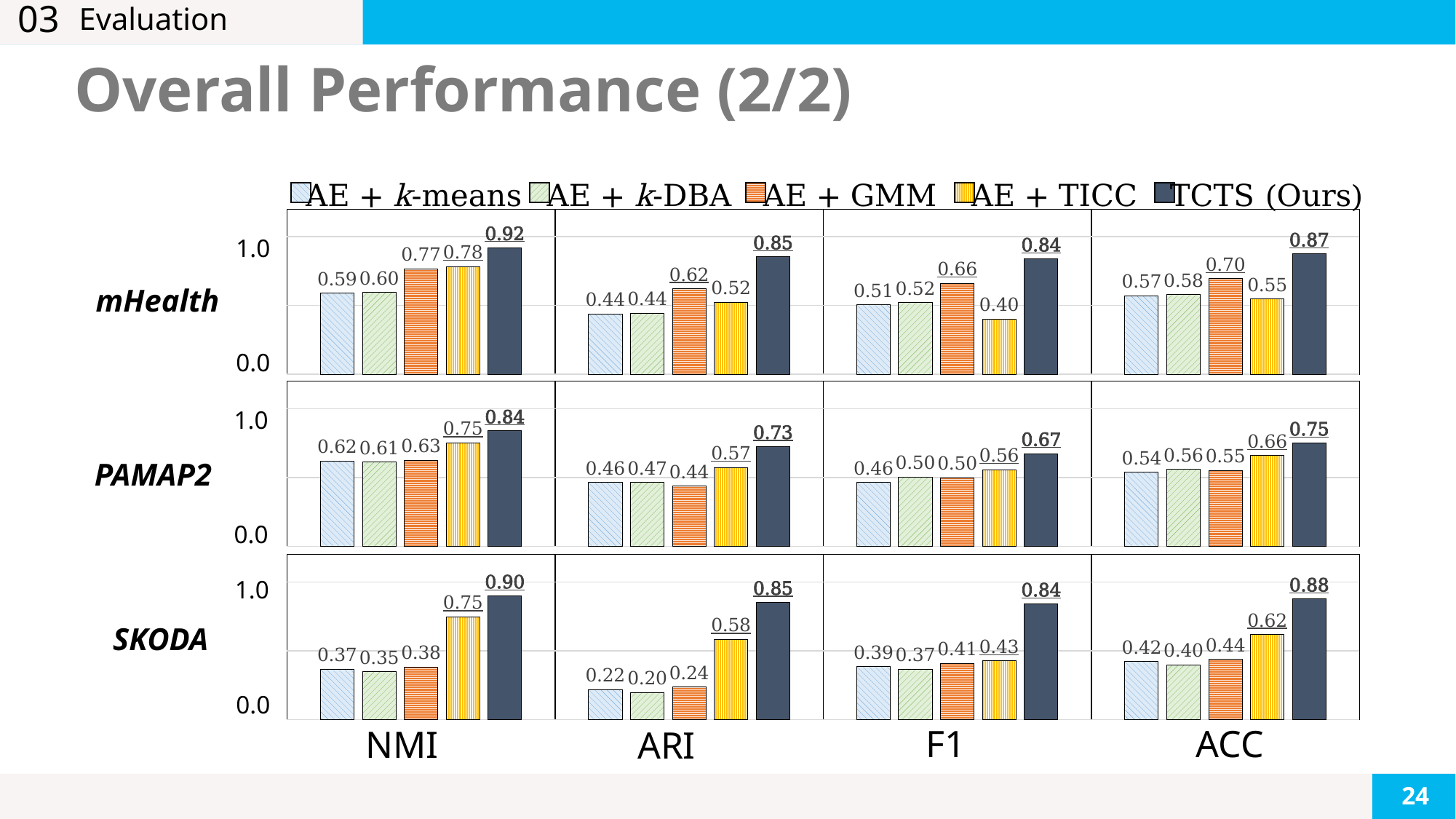
In the mHealth ARI chart, what is the difference between TCTS (Ours) and AE + GMM? 0.23 How many bars are shown in the PAMAP2 F1 chart? 5 In the PAMAP2 ACC chart, what is the value for AE + TICC? 0.66 In the mHealth NMI chart, what is the value for TCTS (Ours)? 0.92 In the SKODA NMI chart, which method has the highest value? TCTS (Ours) What type of chart is used on this slide? Bar chart Which four metrics are shown along the bottom of the charts? NMI, ARI, F1, ACC In the SKODA ACC chart, what is the difference between TCTS (Ours) and AE + TICC? 0.26 How many methods does the legend list? 5 In the PAMAP2 ARI chart, which is larger: AE + GMM or AE + TICC? AE + TICC In the SKODA ARI chart, what is the value for AE + k-DBA? 0.20 In the mHealth F1 chart, which method has the lowest value? AE + TICC